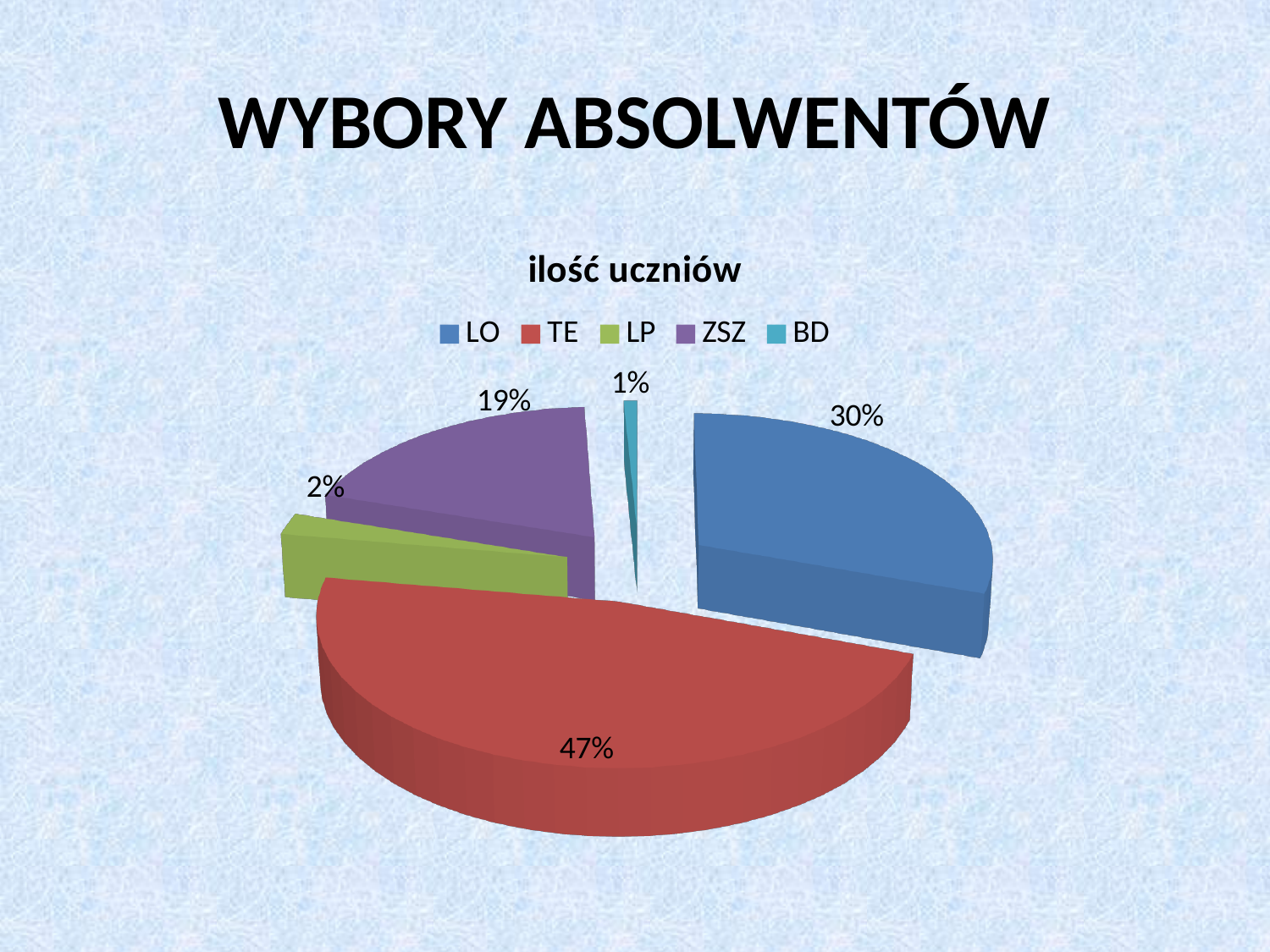
Which is larger, the share of ZSZ or the share of LO? LO Which category has the smallest slice? BD What is the difference between the shares of TE and LO? 17% What share of the pie does LP have? 2% What share of the pie does ZSZ have? 19% What share of the pie does TE have? 47% What is the title of the chart? ilość uczniów How many categories does the legend list? 5 What kind of chart is shown on the slide? pie chart Which category has the largest slice? TE